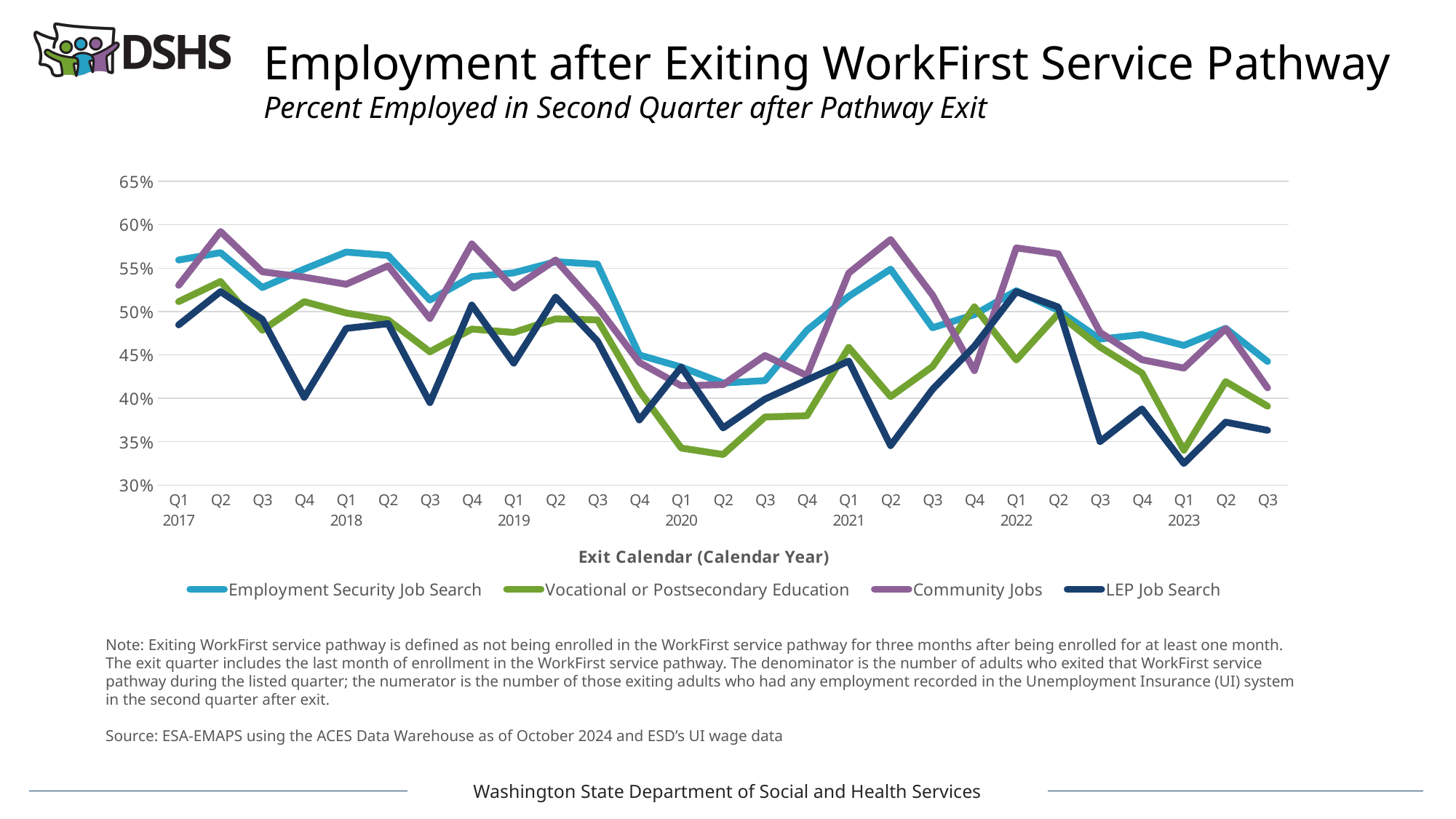
In Q2 2017, which is larger: Community Jobs or LEP Job Search? Community Jobs In Q3 2023, which is larger: Employment Security Job Search or LEP Job Search? Employment Security Job Search Is the value for Community Jobs in Q2 2017 greater or less than 55%? greater What is the x-axis title of the chart? Exit Calendar (Calendar Year) Is the value for Employment Security Job Search in Q2 2021 greater or less than 50%? greater How many series does the legend list? 4 Is the value for Vocational or Postsecondary Education in Q2 2020 greater or less than 35%? less How many quarterly points are plotted along the x axis, from Q1 2017 to Q3 2023? 27 Overall, does the Employment Security Job Search line rise or fall from Q1 2017 to Q3 2023? Fall What kind of chart is shown on the slide? Line chart Which series has the highest value in Q2 2021? Community Jobs